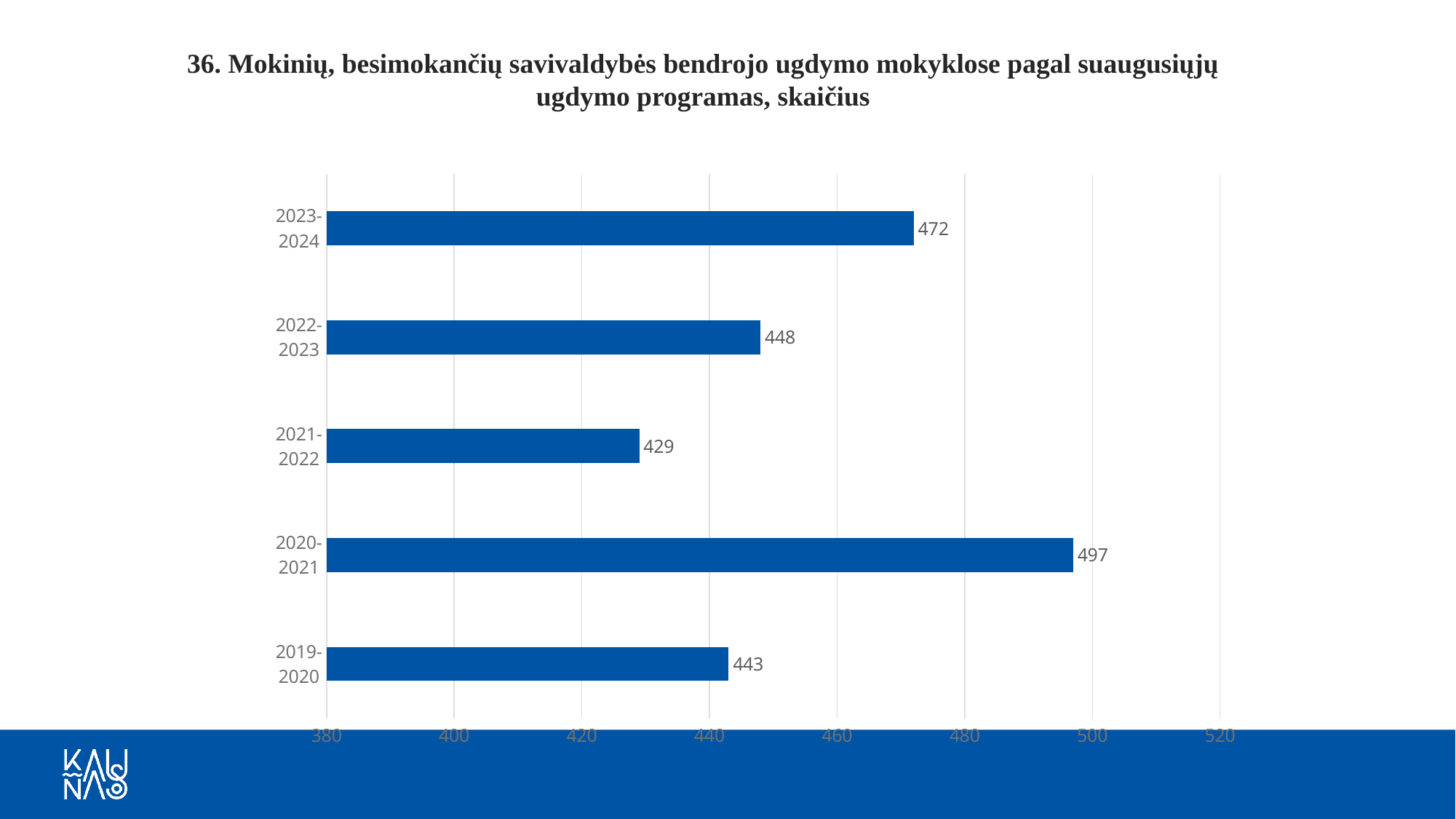
Which school year has the lowest value? 2021-2022 How many school years are shown in the chart? 5 What is the number in front of the chart title? 36 What is the value for 2023-2024? 472 What kind of chart is shown on the slide? bar chart Is the value for 2020-2021 greater or less than 480? greater Which is larger, the value for 2022-2023 or the value for 2019-2020? 2022-2023 What is the difference between the values for 2020-2021 and 2021-2022? 68 Which school year has the highest value? 2020-2021 What is the value for 2019-2020? 443 What is the value for 2021-2022? 429 What is the difference between the values for 2023-2024 and 2022-2023? 24